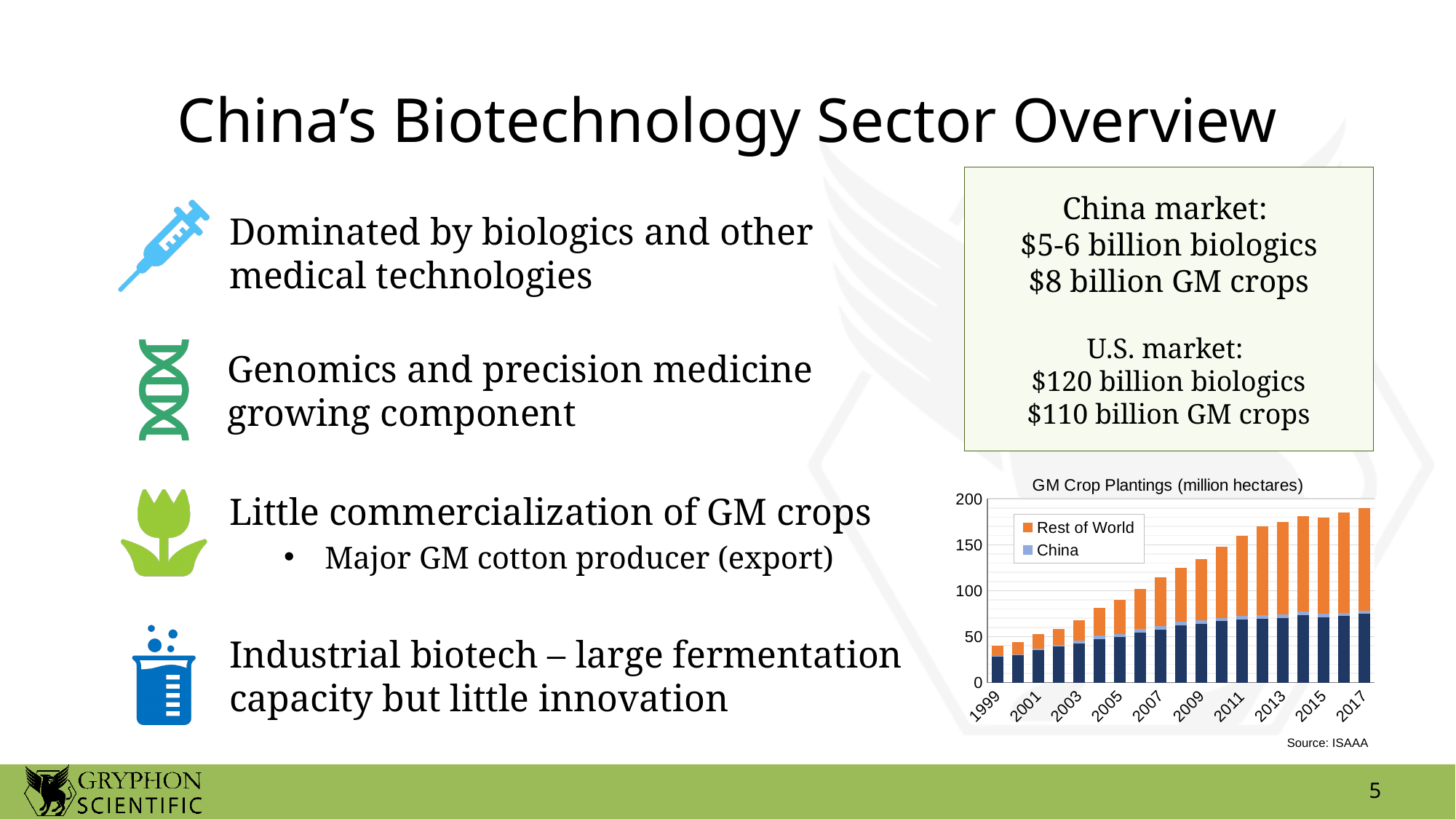
Is the total GM crop plantings value for 2009 greater or less than 100 million hectares? greater In 2017, which series has the larger share of GM crop plantings, China or Rest of World? Rest of World How many years (bars) are plotted in the GM Crop Plantings chart? 19 Is the total GM crop plantings value for 2017 greater or less than 150 million hectares? greater Which year has the highest total GM crop plantings in the chart? 2017 Do total GM crop plantings rise or fall from 1999 to 2017 in the chart? Rise How many series does the legend of the GM Crop Plantings chart list? 2 What kind of chart is the GM Crop Plantings chart? Stacked bar chart What is the source cited for the GM Crop Plantings chart? ISAAA Is the total GM crop plantings value for 1999 greater or less than 50 million hectares? less Which year has the lowest total GM crop plantings in the chart? 1999